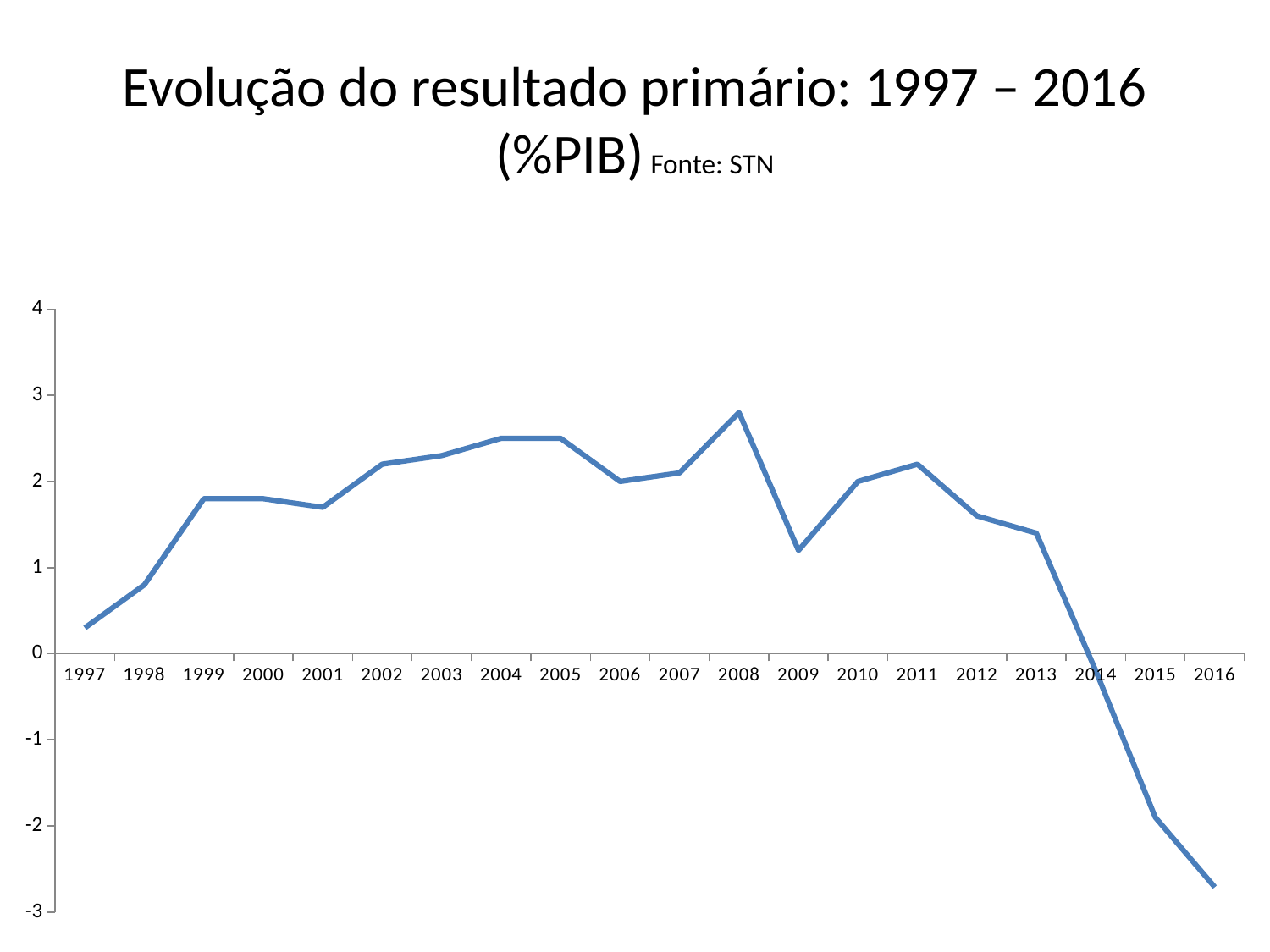
Is the value for 2008 greater or less than 2? greater Is the value for 1997 greater or less than 1? less Which year has the highest value? 2008 Is the value for 2015 greater or less than -1? less How many years are plotted on the x axis? 20 Do the values rise or fall from 2013 to 2016? fall What kind of chart is shown on the slide? line chart Which is larger, the value for 2008 or the value for 2009? 2008 What is the title of the chart? Evolução do resultado primário: 1997 – 2016 (%PIB) Which year has the lowest value? 2016